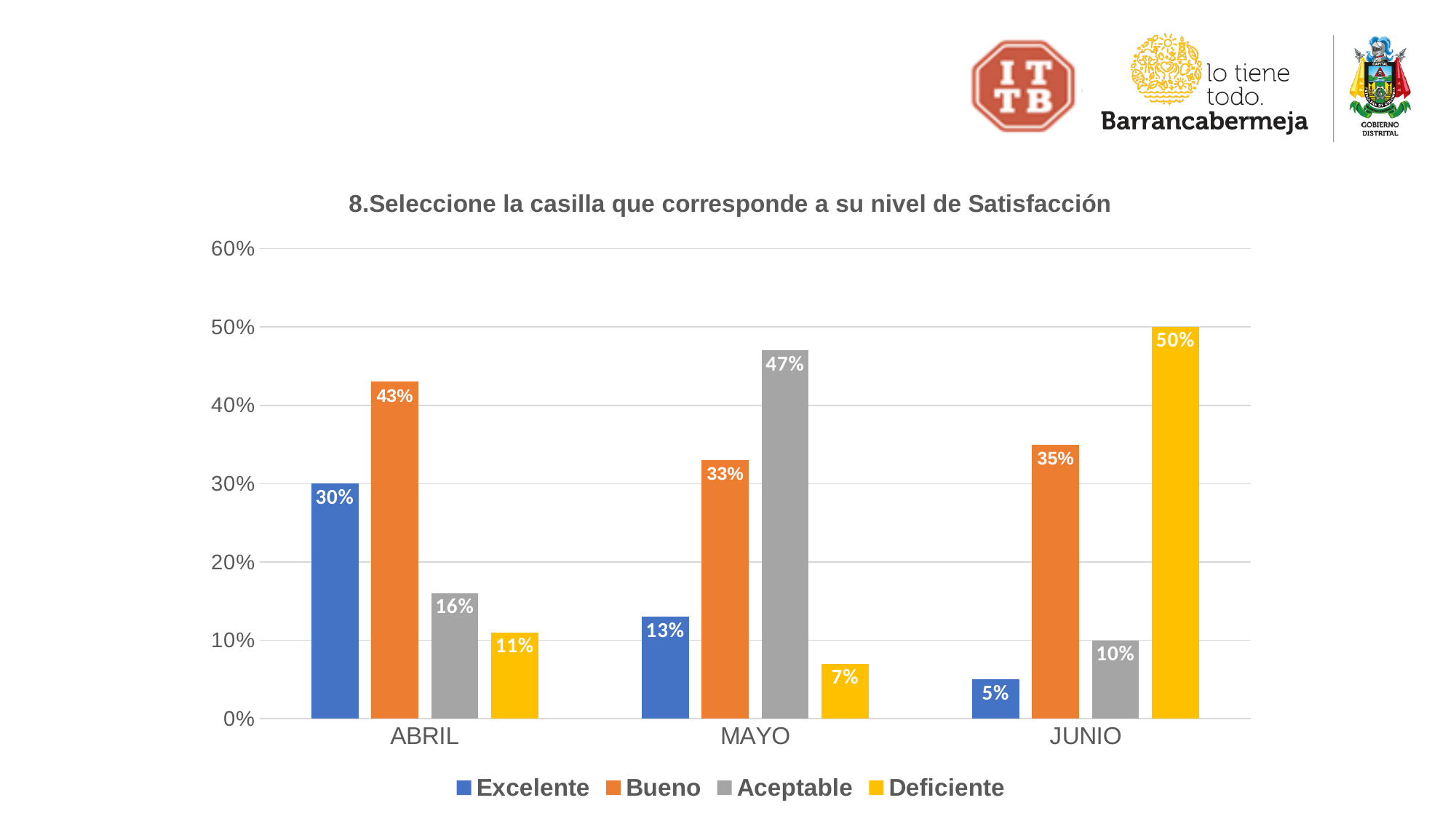
What is the value for Bueno in ABRIL? 43% Which month has the lowest value for Deficiente? MAYO What kind of chart is shown on the slide? Bar chart Which month has the highest value for Excelente? ABRIL What is the value for Aceptable in MAYO? 47% What is the difference between the Bueno values for ABRIL and JUNIO? 8% How many series does the legend list? 4 What is the value for Excelente in MAYO? 13% What is the value for Deficiente in JUNIO? 50% Do the Excelente values rise or fall from ABRIL to JUNIO? Fall Which is larger: Aceptable in ABRIL or Aceptable in JUNIO? Aceptable in ABRIL How many months are shown on the x axis? 3